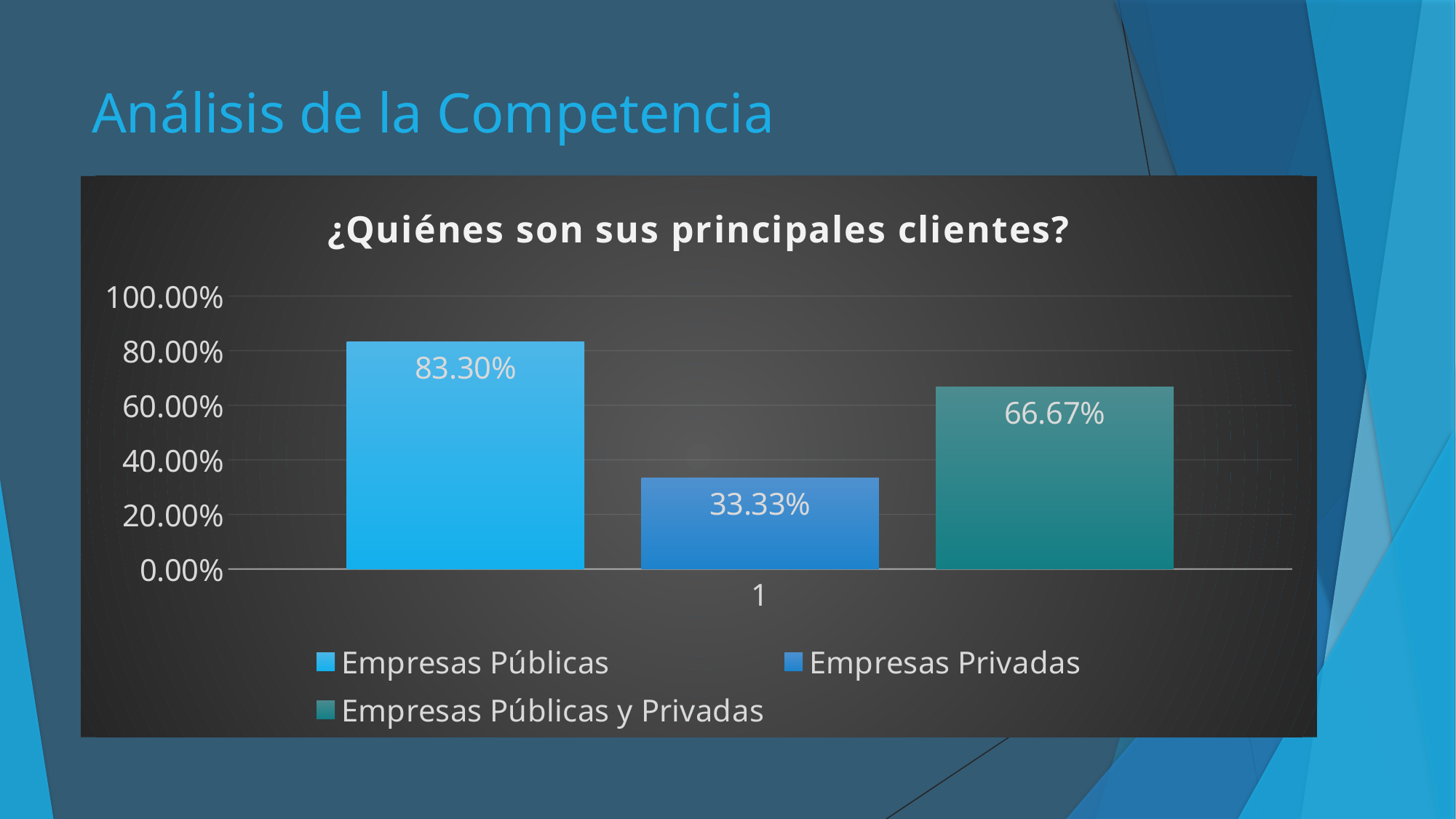
Which series has the highest value? Empresas Públicas Which is larger, the value for Empresas Privadas or the value for Empresas Públicas y Privadas? Empresas Públicas y Privadas What is the title of the chart? ¿Quiénes son sus principales clientes? What is the difference between the values for Empresas Públicas and Empresas Privadas? 49.97% What is the difference between the values for Empresas Públicas and Empresas Públicas y Privadas? 16.63% What is the value for Empresas Privadas? 33.33% How many series does the legend list? 3 What kind of chart is shown on the slide? bar chart What is the value for Empresas Públicas? 83.30% Is the value for Empresas Privadas greater or less than 40.00%? less Which series has the lowest value? Empresas Privadas What is the value for Empresas Públicas y Privadas? 66.67%